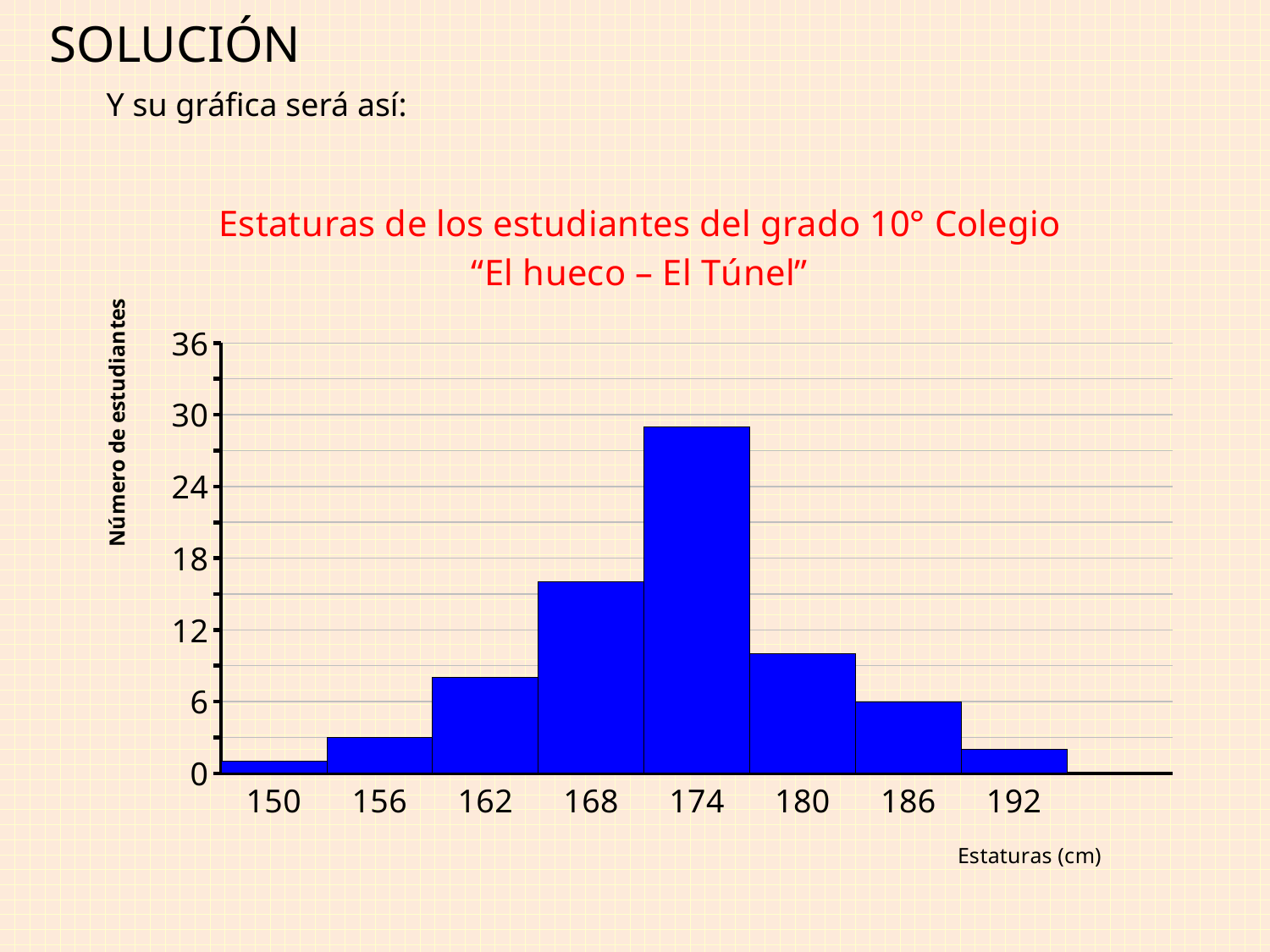
Is the value for 180 greater or less than 6? greater Which has more students, the 168 category or the 180 category? 168 Is the value for 168 greater or less than 18? less What is the label of the vertical axis? Número de estudiantes What kind of chart is shown on the slide? bar chart Which height category has the highest number of students? 174 Is the value for 174 greater or less than 24? greater Which height category has the lowest number of students? 150 How many height categories are shown on the x axis? 8 What is the number of students for the 186 cm category? 6 What is the label of the horizontal axis? Estaturas (cm)